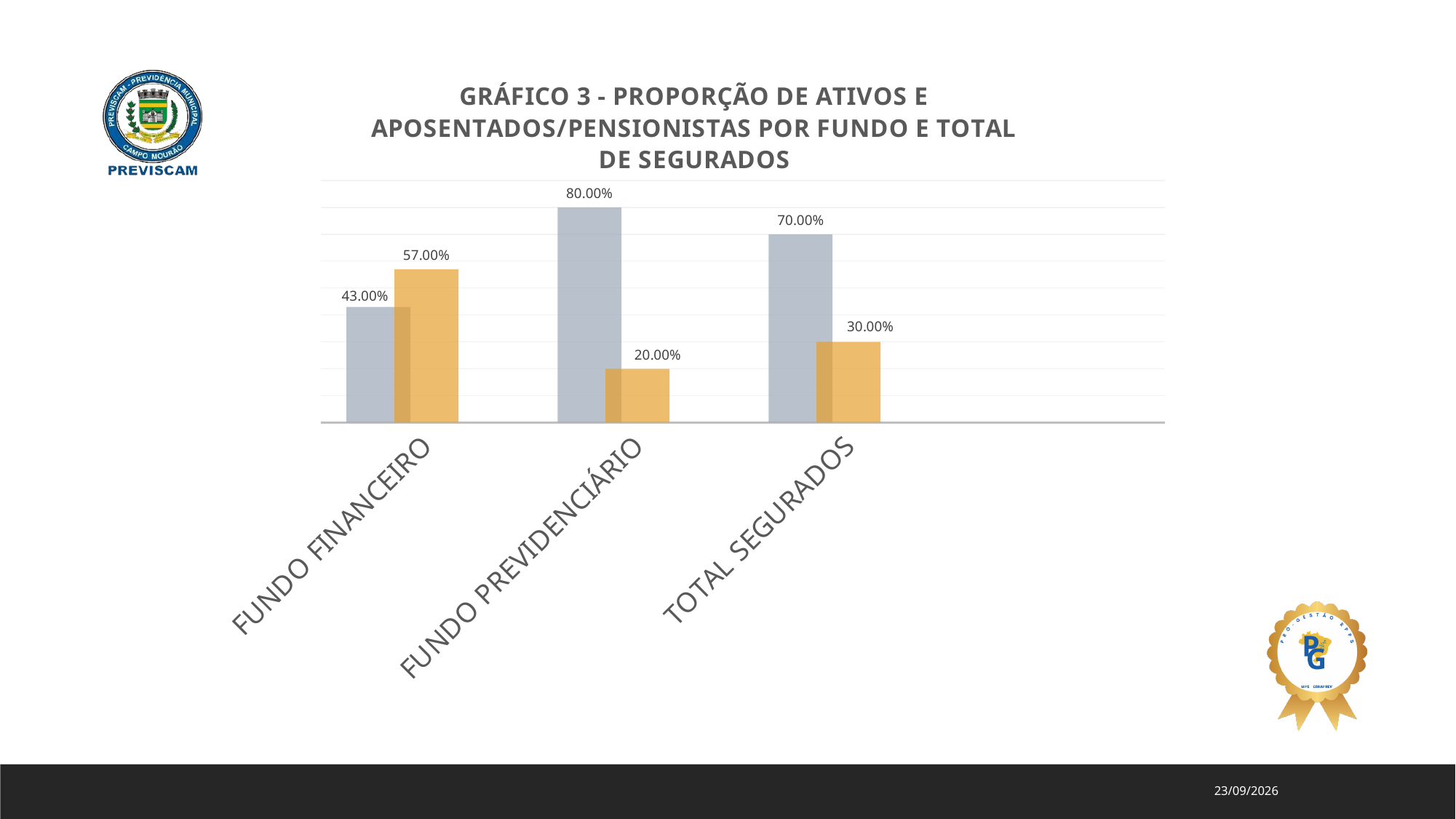
What is the title of the chart? GRÁFICO 3 - PROPORÇÃO DE ATIVOS E APOSENTADOS/PENSIONISTAS POR FUNDO E TOTAL DE SEGURADOS What is the difference between the grey bar for TOTAL SEGURADOS and the grey bar for FUNDO FINANCEIRO? 27.00% For FUNDO FINANCEIRO, which bar is larger, the grey one or the orange one? the orange one What is the value of the orange bar for TOTAL SEGURADOS? 30.00% How many categories are shown on the x axis? 3 Which category has the highest grey bar? FUNDO PREVIDENCIÁRIO What is the difference between the grey and orange bars for FUNDO PREVIDENCIÁRIO? 60.00% What kind of chart is shown on the slide? bar chart What is the value of the grey bar for FUNDO PREVIDENCIÁRIO? 80.00% What is the value of the orange bar for FUNDO FINANCEIRO? 57.00% Which category has the lowest orange bar? FUNDO PREVIDENCIÁRIO What is the value of the grey bar for FUNDO FINANCEIRO? 43.00%